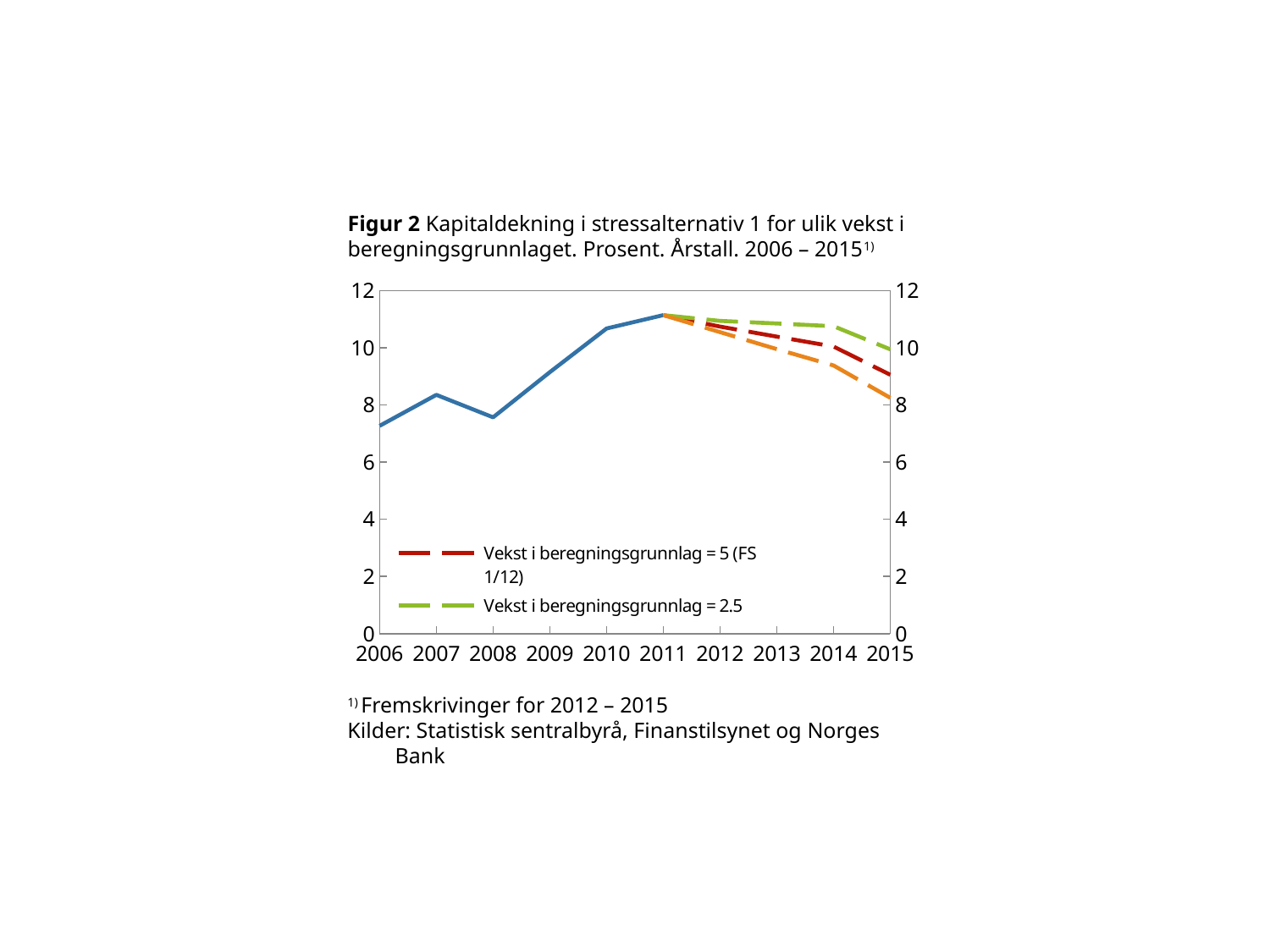
Is the value for 'Vekst i beregningsgrunnlag = 2.5' in 2014 greater or less than 10? greater How many years are labelled on the x axis? 10 Is the value of the solid line in 2010 greater or less than 10? greater Is the value for 'Vekst i beregningsgrunnlag = 5 (FS 1/12)' in 2015 greater or less than 10? less In 2015, which is higher: 'Vekst i beregningsgrunnlag = 5 (FS 1/12)' or 'Vekst i beregningsgrunnlag = 2.5'? Vekst i beregningsgrunnlag = 2.5 What kind of chart is shown on the slide? line chart Does the solid line rise or fall overall from 2008 to 2011? rise What is the maximum value shown on the y axis? 12 Do the dashed projection lines rise or fall from 2011 to 2015? fall How many entries does the legend list? 2